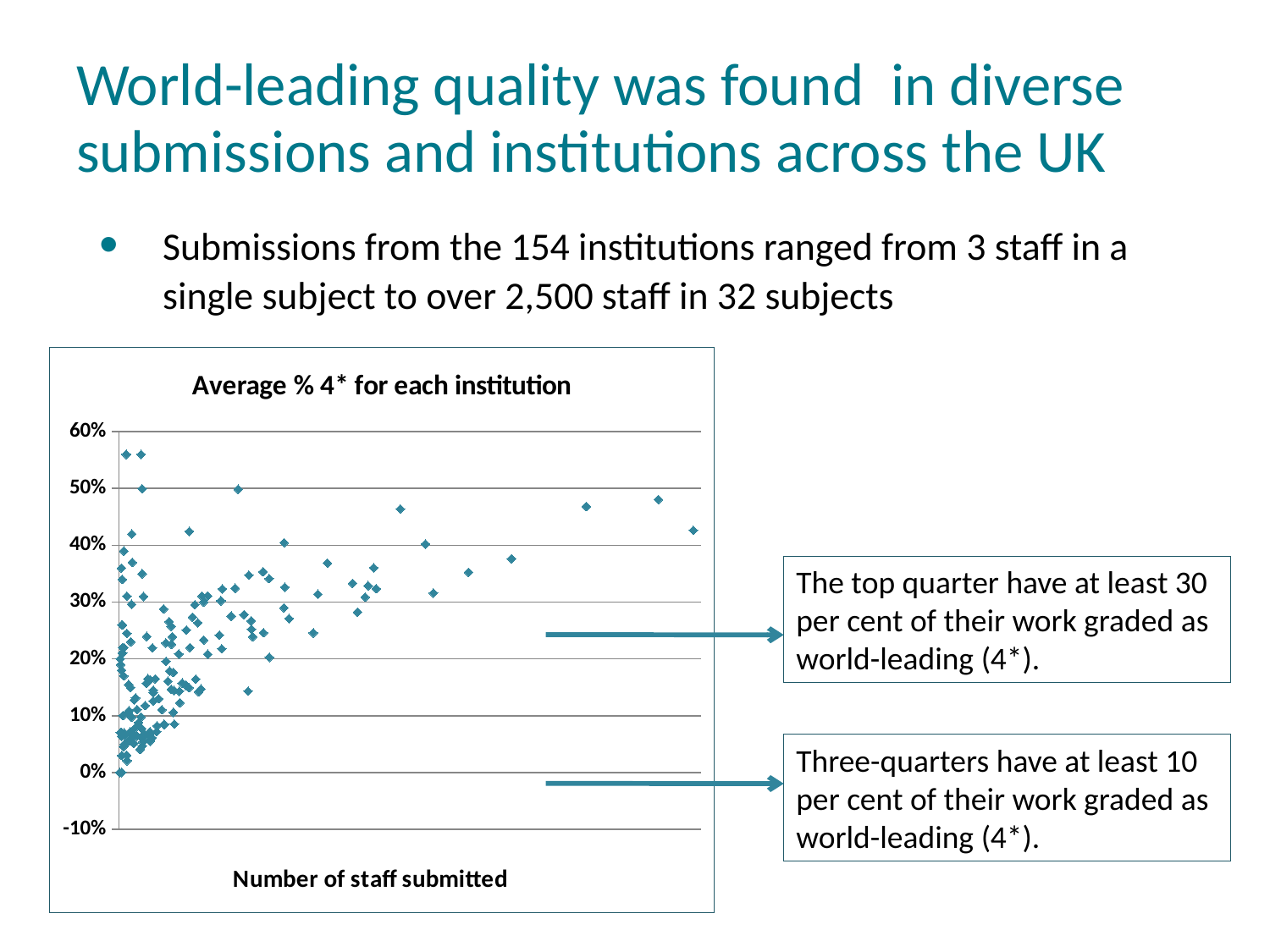
What is the lowest value shown on the y axis of the chart? -10% Is the rightmost plotted point in the chart greater or less than 40%? greater Is the highest plotted point in the chart greater or less than 50%? greater Is the lowest plotted point in the chart greater or less than 10%? less What is the title of the chart? Average % 4* for each institution What is the highest value shown on the y axis of the chart? 60% What is the label on the x axis of the chart? Number of staff submitted What is the interval between consecutive y-axis tick labels on the chart? 10% How many tick labels are shown on the y axis of the chart? 8 Does the chart display a legend? No What kind of chart is shown on the slide? Scatter chart